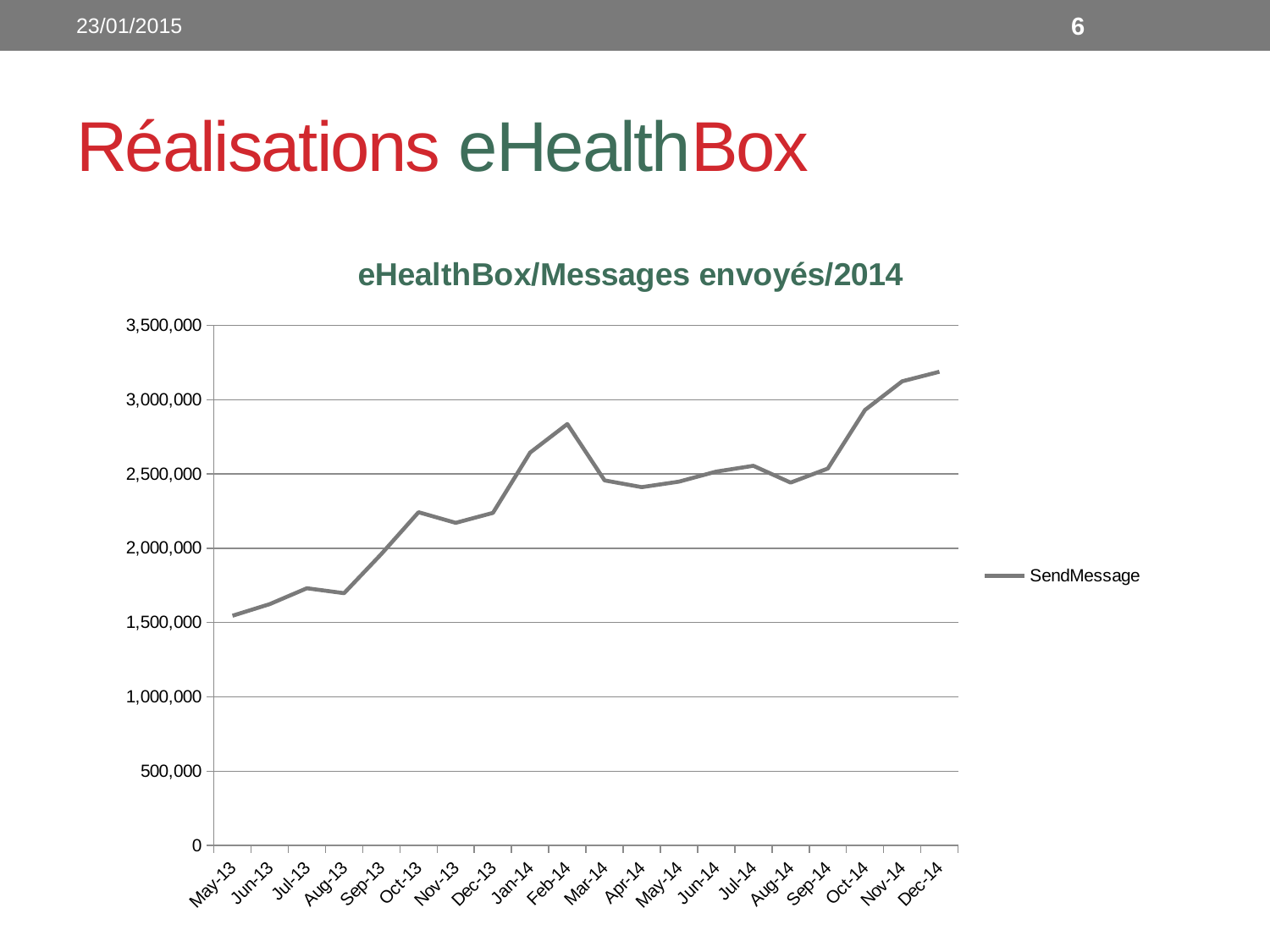
Is the value for May-13 greater or less than 2,000,000? less Is the value for Dec-14 greater or less than 3,000,000? greater What is the name of the series shown in the legend? SendMessage Which month has the highest value for SendMessage? Dec-14 Which month has the lowest value for SendMessage? May-13 Which is larger, the value for Feb-14 or the value for Mar-14? Feb-14 What is the title of the chart? eHealthBox/Messages envoyés/2014 Overall, do the values rise or fall from May-13 to Dec-14? rise What kind of chart is shown on the slide? line chart How many series does the legend list? 1 How many months are plotted along the x axis? 20 Is the value for Feb-14 greater or less than 2,500,000? greater